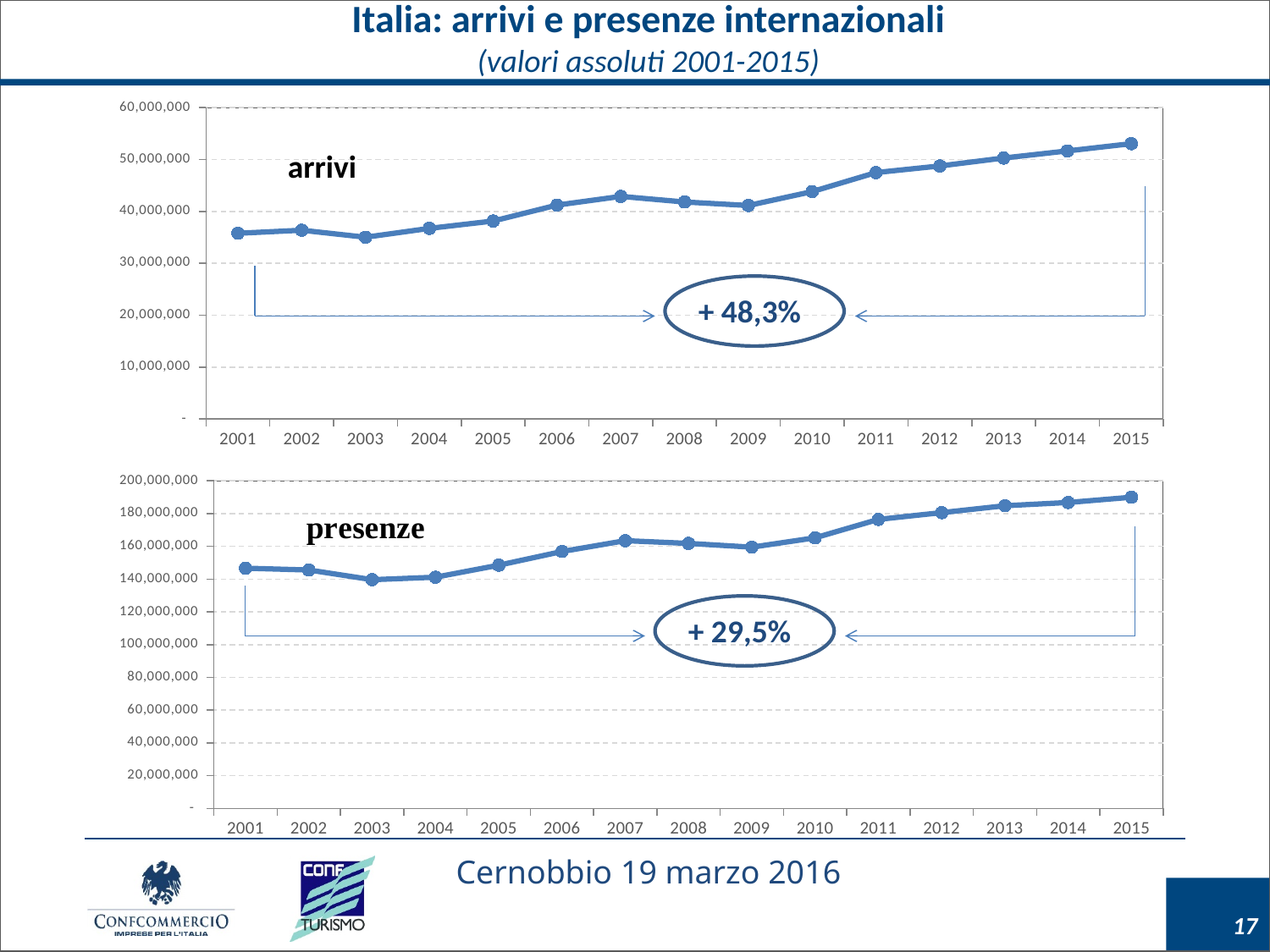
In the top chart (arrivi), is the value for 2001 greater or less than 40,000,000? less What percentage change is shown in the annotation on the top chart (arrivi)? + 48,3% What kind of chart is the top chart labelled "arrivi"? line chart In the top chart (arrivi), which is larger, the value for 2005 or the value for 2010? 2010 In the bottom chart (presenze), which is larger, the value for 2004 or the value for 2007? 2007 In the bottom chart (presenze), which year has the highest value? 2015 In the bottom chart (presenze), do the values overall rise or fall from 2001 to 2015? rise In the bottom chart (presenze), is the value for 2015 greater or less than 180,000,000? greater In the top chart (arrivi), is the value for 2015 greater or less than 50,000,000? greater In the top chart (arrivi), which year has the highest value? 2015 How many years are plotted on the x axis of the bottom chart labelled "presenze"? 15